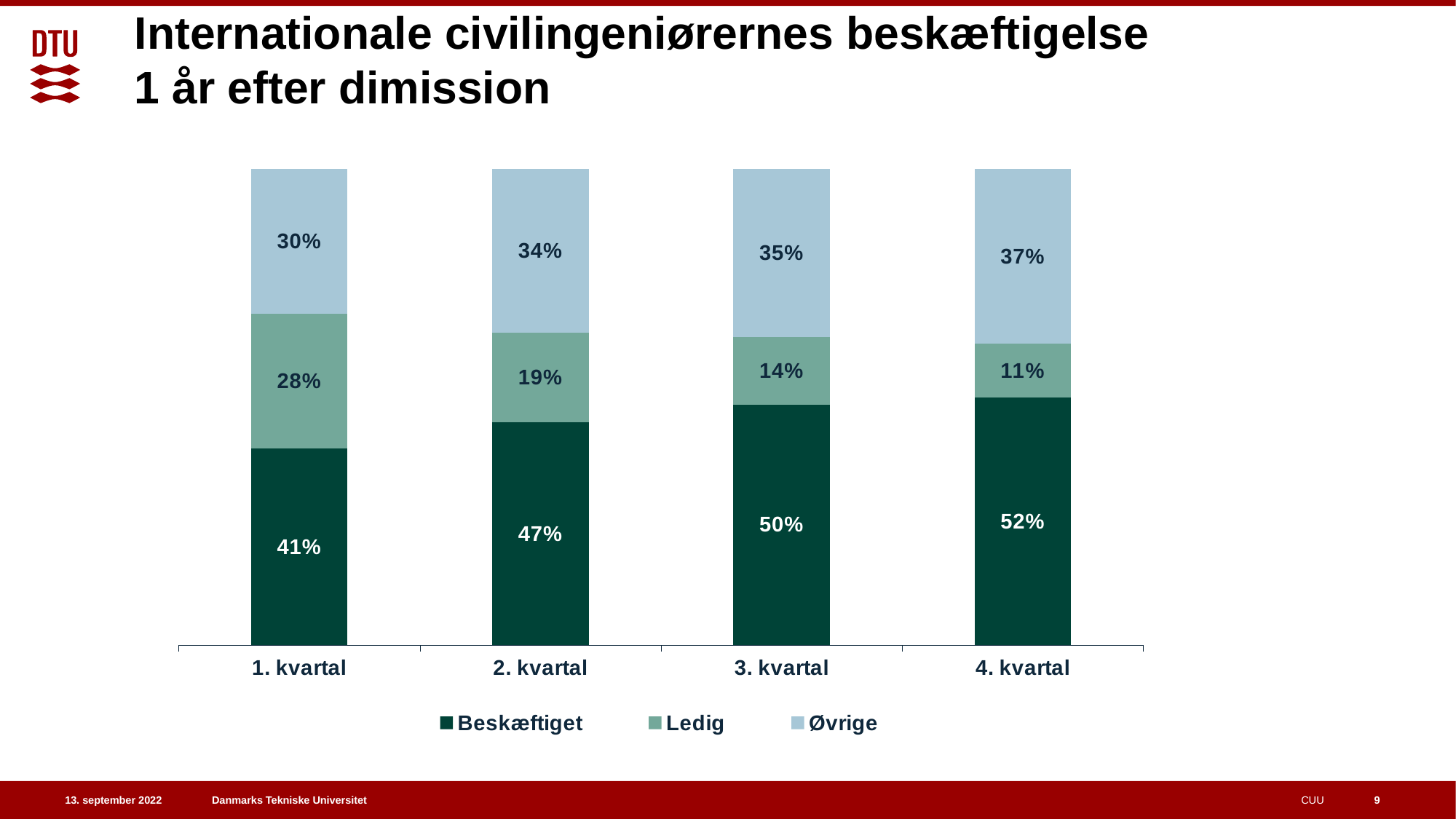
How many series does the legend list? 3 What kind of chart is shown on the slide? Stacked bar chart What is the Øvrige value for 4. kvartal? 37% What is the total of the stacked bar for 2. kvartal? 100% Which quarter has the highest Beskæftiget value? 4. kvartal What is the Ledig value for 1. kvartal? 28% Does the Beskæftiget value rise or fall from 1. kvartal to 4. kvartal? Rise What is the Beskæftiget value for 3. kvartal? 50% Which is larger: the Ledig value for 2. kvartal or the Ledig value for 3. kvartal? 2. kvartal What is the difference between the Beskæftiget values for 4. kvartal and 1. kvartal? 11% Which quarter has the lowest Ledig value? 4. kvartal How many quarters are shown on the x axis? 4